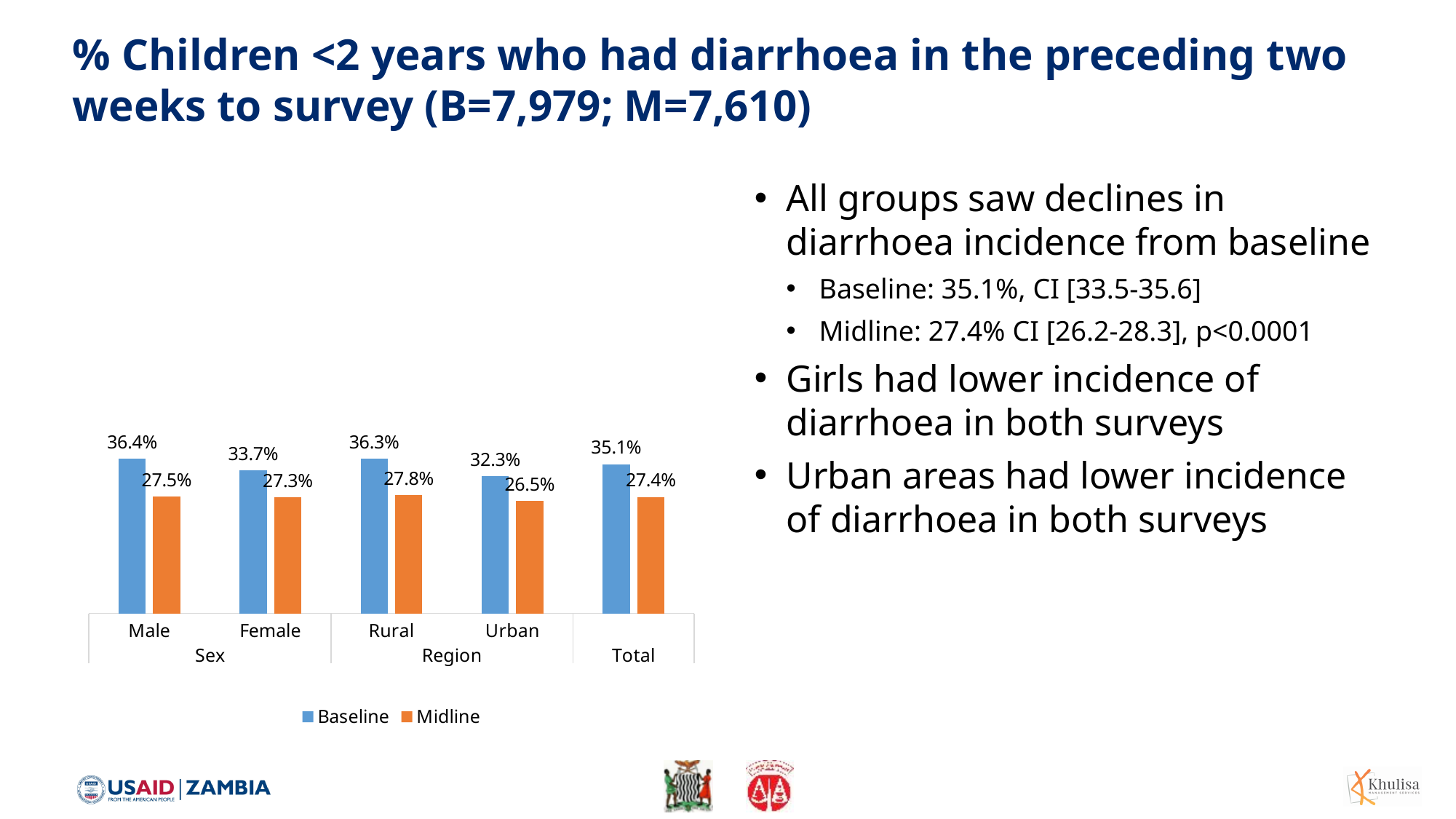
What is the Midline value for Urban? 26.5% What is the difference between the Baseline and Midline values for Rural? 8.5% How many categories are shown on the x axis? 5 Which colour represents the Midline series? Orange What is the Midline value for Total? 27.4% What is the Baseline value for Male? 36.4% Which category has the lowest Midline value? Urban How many series does the legend list? 2 Which is larger, the Baseline value for Rural or the Baseline value for Urban? Rural What kind of chart is shown on the slide? Bar chart What is the difference between the Baseline values for Male and Female? 2.7% Which category has the highest Baseline value? Male